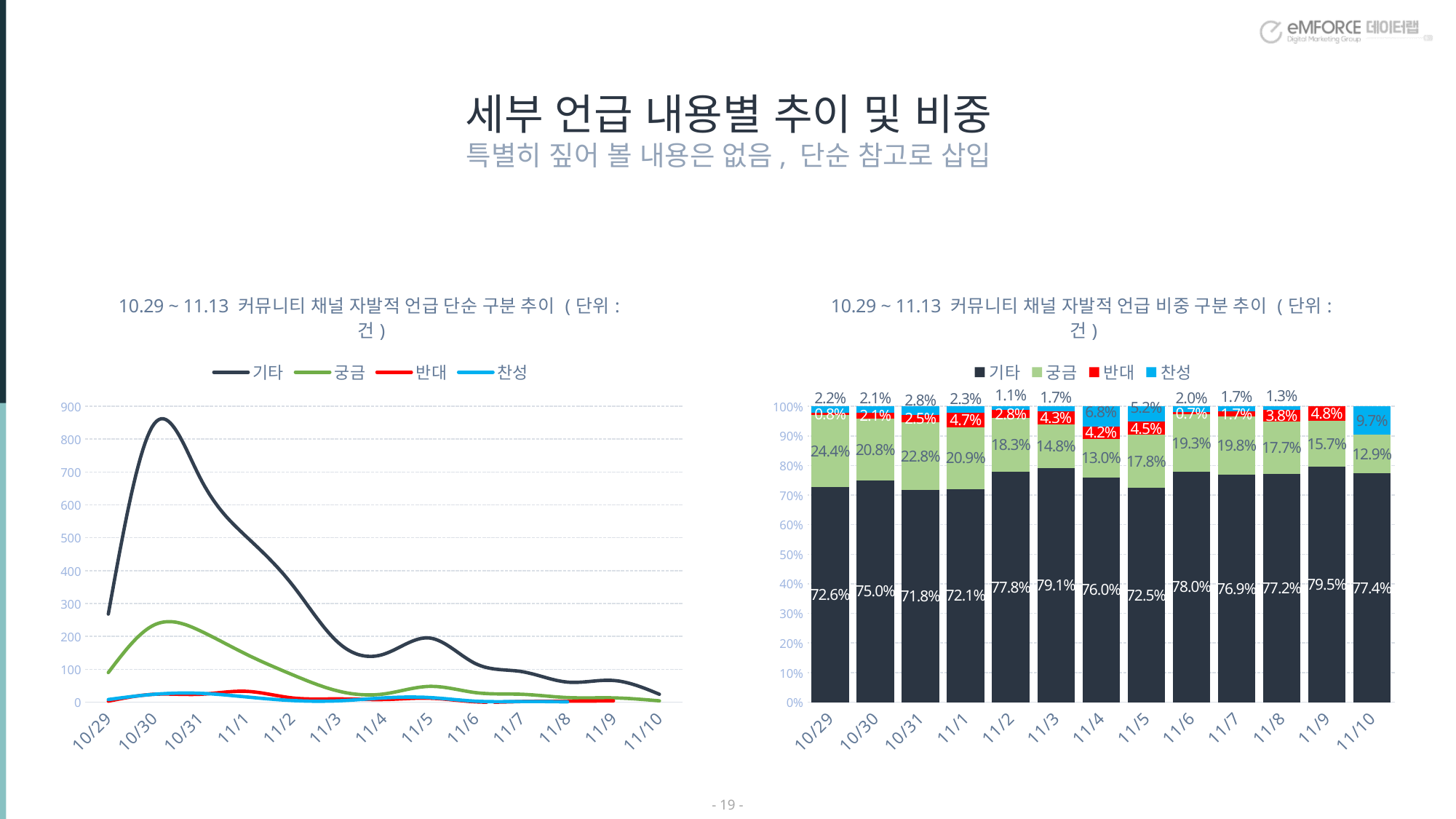
In the right chart, what is the share of 기타 on 11/3? 79.1% In the right chart, what is the difference between the 궁금 share on 10/29 and on 11/10? 11.5 percentage points In the right chart, which is larger: the 반대 share on 11/1 or on 11/6? 11/1 What kind of chart is the right chart (10.29 ~ 11.13 커뮤니티 채널 자발적 언급 비중 구분 추이)? stacked bar chart In the right chart, what is the share of 궁금 on 10/29? 24.4% In the left chart, on which date does the 기타 line reach its peak? 10/30 In the right chart, on which date is the share of 궁금 the lowest? 11/10 In the left chart, is the value for 기타 on 10/30 greater or less than 800? greater In the right chart, what is the share of 찬성 on 11/10? 9.7% How many series does the legend of the left chart list? 4 How many dates are shown on the x axis of the right chart? 13 What kind of chart is the left chart (10.29 ~ 11.13 커뮤니티 채널 자발적 언급 단순 구분 추이)? line chart